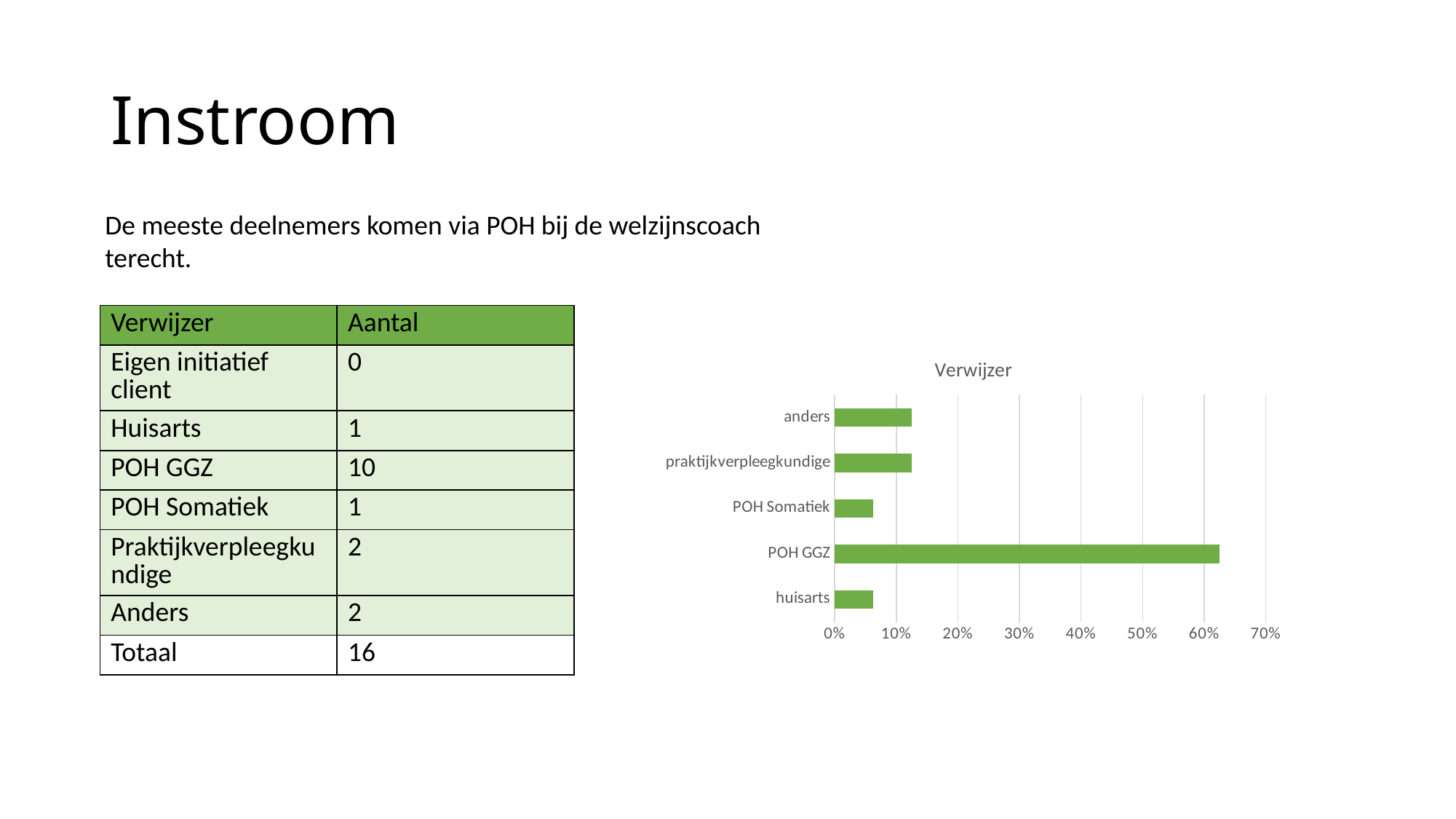
Is the value for huisarts greater or less than 10%? less Which is larger, the value for POH GGZ or the value for huisarts? POH GGZ Is the value for praktijkverpleegkundige greater or less than 20%? less How many categories are plotted in the chart? 5 What is the title of the chart? Verwijzer Is the value for anders greater or less than 10%? greater Which is larger, the value for anders or the value for POH Somatiek? anders What kind of chart is shown on the slide? bar chart Which category has the highest value in the chart? POH GGZ